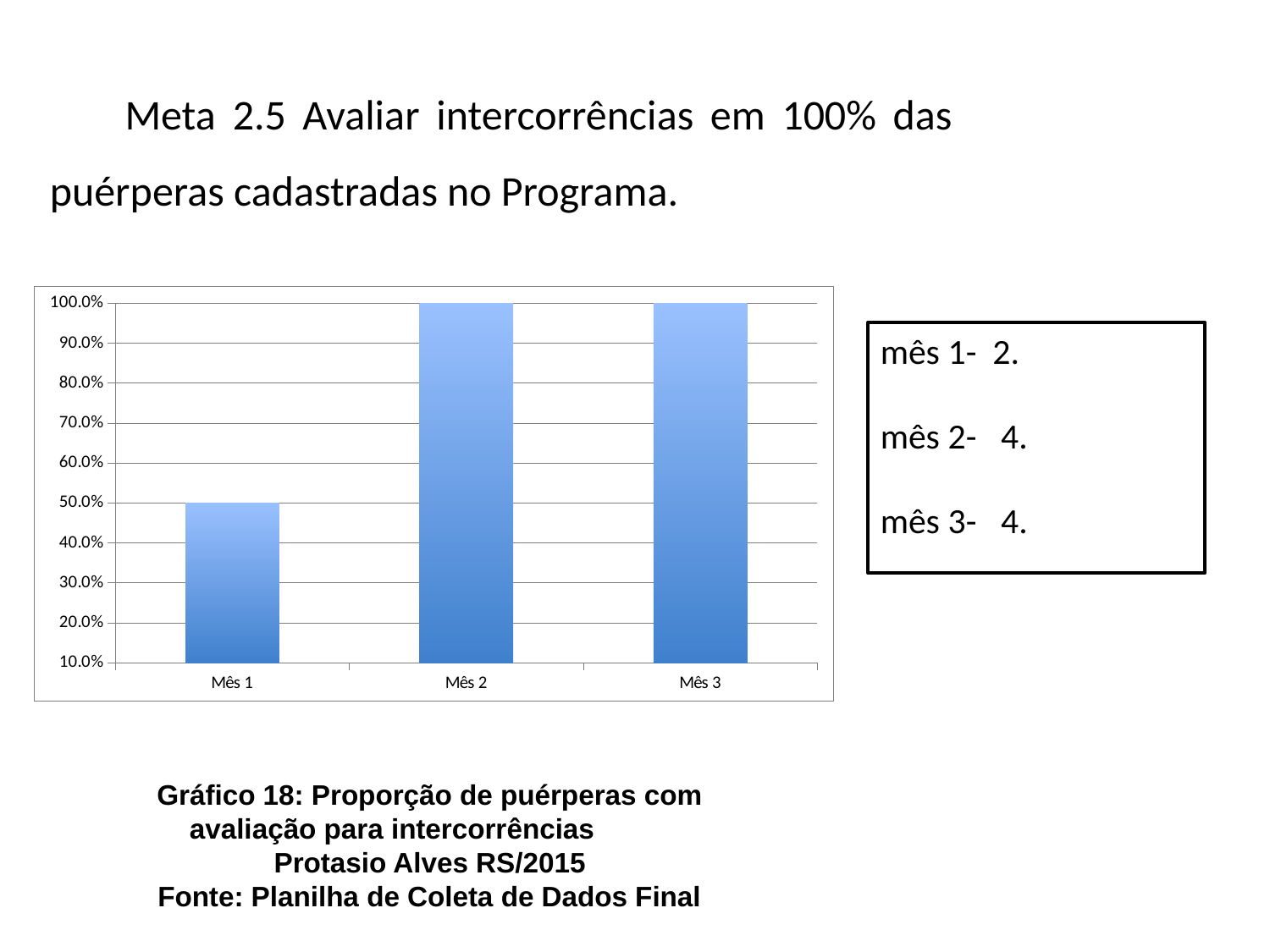
Is the value for Mês 3 greater or less than 90.0%? greater What is the difference between the value for Mês 2 and the value for Mês 1? 50.0% What is the value for Mês 3 in the chart? 100.0% Is the value for Mês 1 greater or less than 60.0%? less Which is larger, the value for Mês 1 or the value for Mês 2? Mês 2 Do the values rise or fall from Mês 1 to Mês 2? rise How many categories are shown on the x axis of the chart? 3 What is the value for Mês 2 in the chart? 100.0% Which category has the lowest value in the chart? Mês 1 What is the value for Mês 1 in the chart? 50.0% What kind of chart is shown on the slide? bar chart What is the lowest value shown on the y axis of the chart? 10.0%